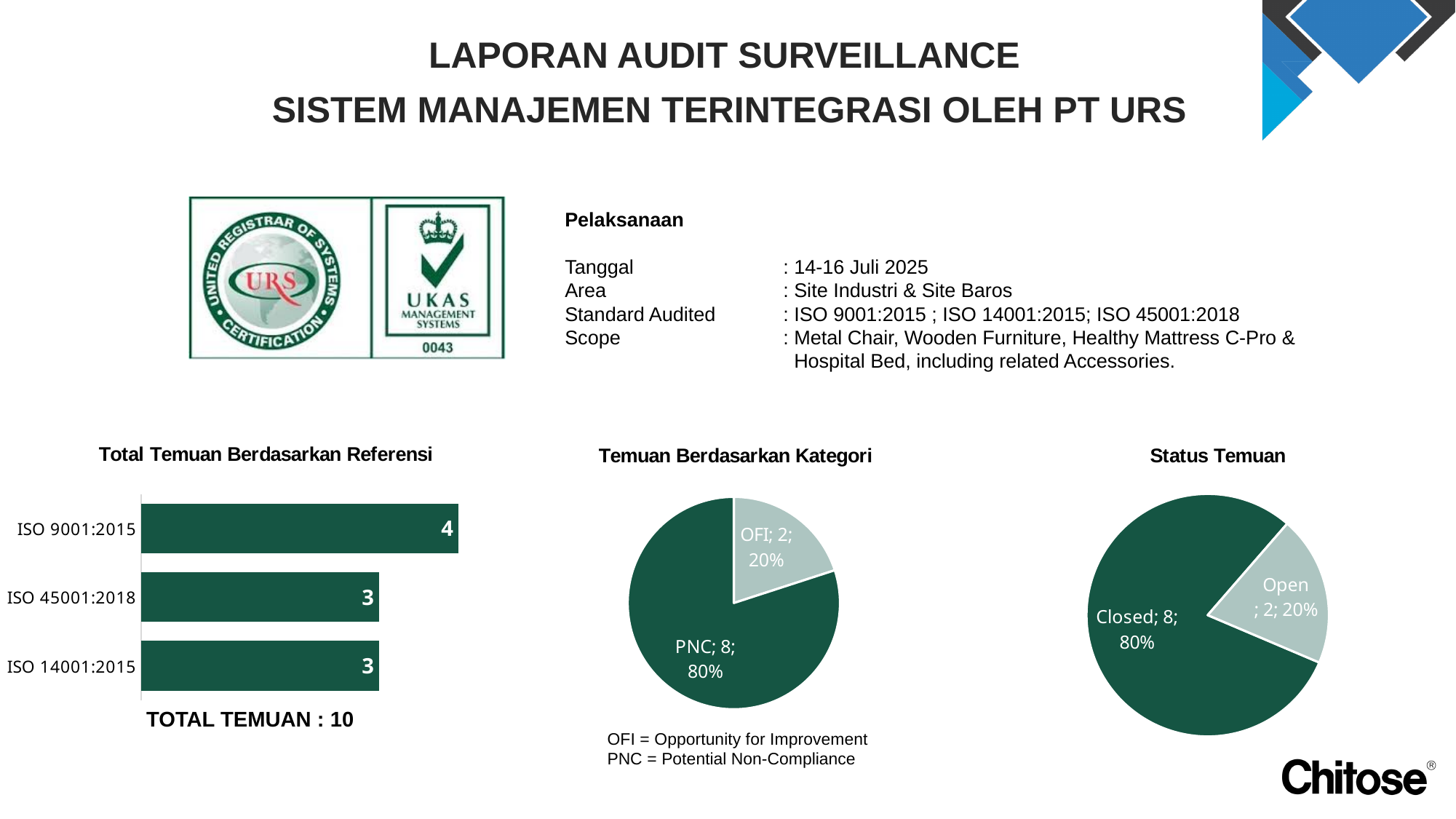
In the 'Status Temuan' chart, what is the value for Open? 2 In the 'Total Temuan Berdasarkan Referensi' chart, how many categories are shown? 3 In the 'Temuan Berdasarkan Kategori' chart, what share of the pie does OFI represent? 20% In the 'Total Temuan Berdasarkan Referensi' chart, what is the value for ISO 45001:2018? 3 In the 'Status Temuan' chart, what share of the pie does Closed represent? 80% In the 'Temuan Berdasarkan Kategori' chart, what is the value for PNC? 8 In the 'Total Temuan Berdasarkan Referensi' chart, what is the difference between the values for ISO 9001:2015 and ISO 14001:2015? 1 In the 'Total Temuan Berdasarkan Referensi' chart, what is the value for ISO 9001:2015? 4 What kind of chart is 'Total Temuan Berdasarkan Referensi'? Bar chart In the 'Total Temuan Berdasarkan Referensi' chart, which standard has the highest number of findings? ISO 9001:2015 What kind of chart is 'Temuan Berdasarkan Kategori'? Pie chart In the 'Status Temuan' chart, which status has the larger share, Closed or Open? Closed